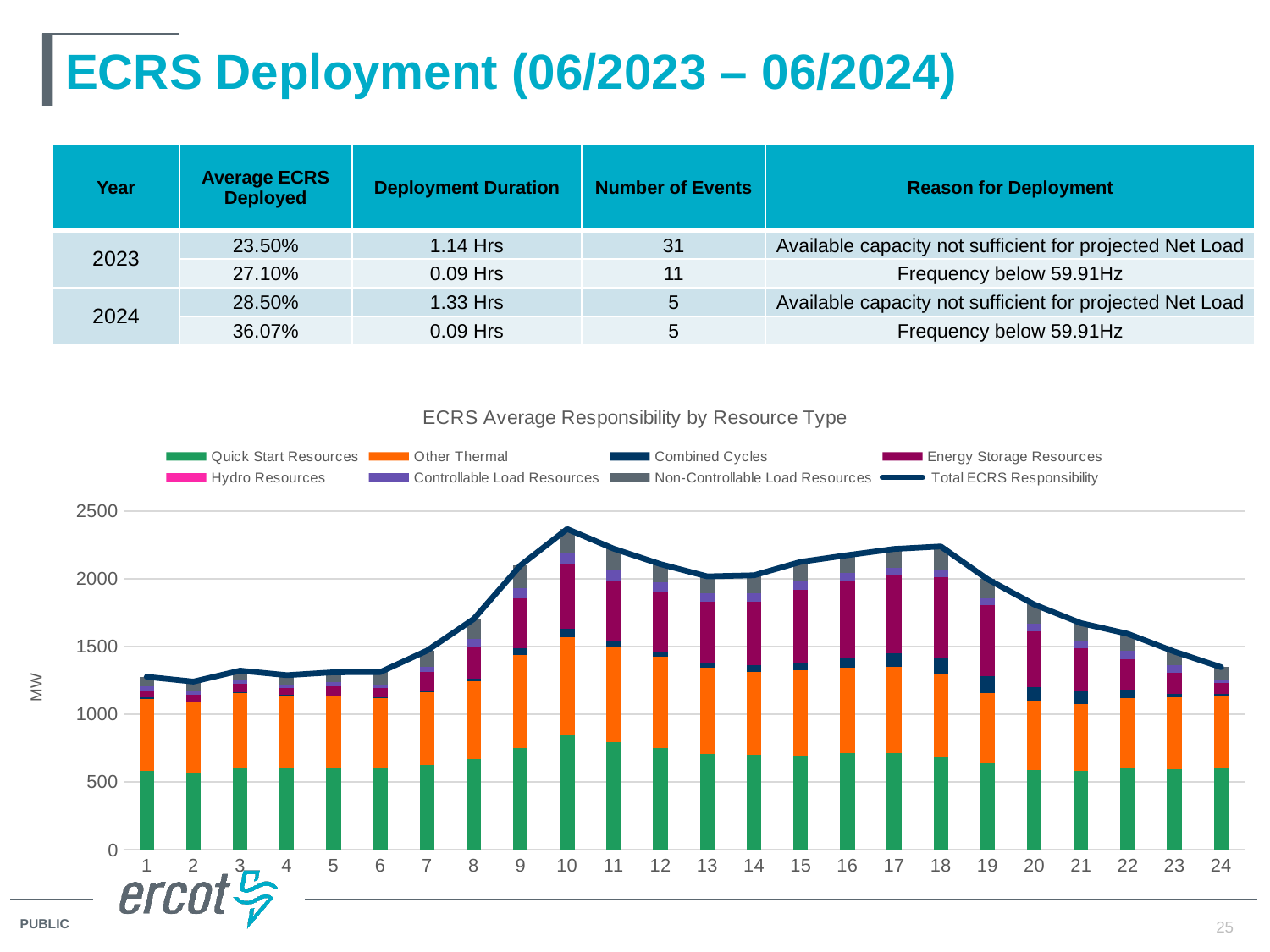
Is the Quick Start Resources segment at category 1 greater or less than 1000? less Is the Total ECRS Responsibility at category 10 greater or less than 2000? greater Which has the larger Total ECRS Responsibility, category 18 or category 13? 18 Is the Total ECRS Responsibility at category 24 greater or less than 1500? less How many series does the chart's legend list? 8 How many categories are shown along the x axis of the chart? 24 What kind of chart is shown on the slide? combination stacked bar and line chart Does the Total ECRS Responsibility line rise or fall from category 6 to category 10? rise At which x-axis category does the Total ECRS Responsibility line reach its highest value? 10 What is the title of the chart on the slide? ECRS Average Responsibility by Resource Type What is the label on the y axis of the chart? MW